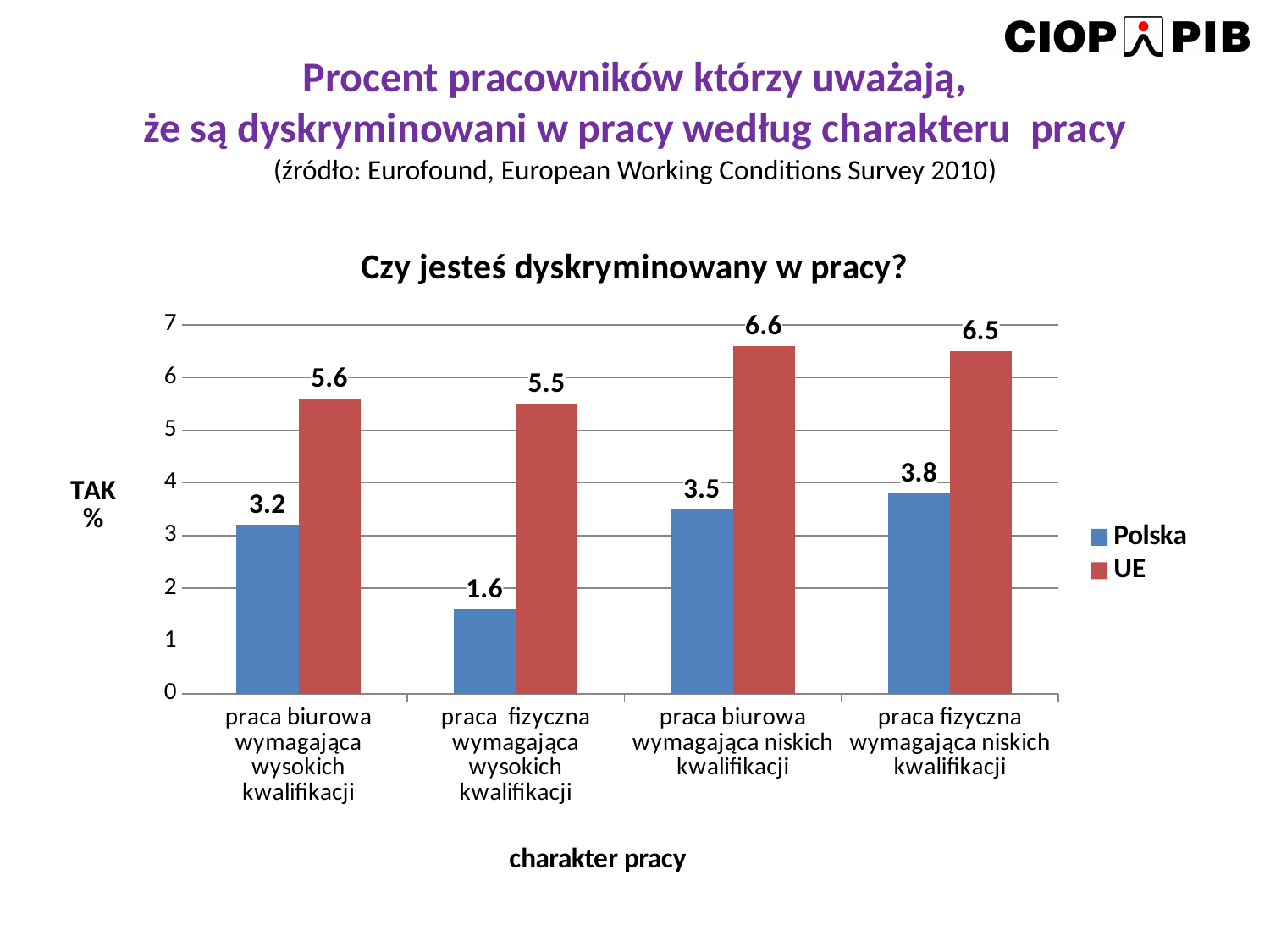
What is the value for UE in the category 'praca fizyczna wymagająca wysokich kwalifikacji'? 5.5 Which is larger: the Polska value for 'praca biurowa wymagająca niskich kwalifikacji' or the Polska value for 'praca fizyczna wymagająca niskich kwalifikacji'? praca fizyczna wymagająca niskich kwalifikacji What is the title of the chart? Czy jesteś dyskryminowany w pracy? What kind of chart is shown on the slide? bar chart How many series does the legend list? 2 What is the value for UE in the category 'praca biurowa wymagająca niskich kwalifikacji'? 6.6 What is the value for Polska in the category 'praca biurowa wymagająca wysokich kwalifikacji'? 3.2 How many categories are shown on the x axis? 4 Which category has the highest value for UE? praca biurowa wymagająca niskich kwalifikacji What is the difference between the UE and Polska values for 'praca fizyczna wymagająca wysokich kwalifikacji'? 3.9 What is the difference between the Polska values for 'praca fizyczna wymagająca niskich kwalifikacji' and 'praca biurowa wymagająca wysokich kwalifikacji'? 0.6 Which category has the lowest value for Polska? praca fizyczna wymagająca wysokich kwalifikacji